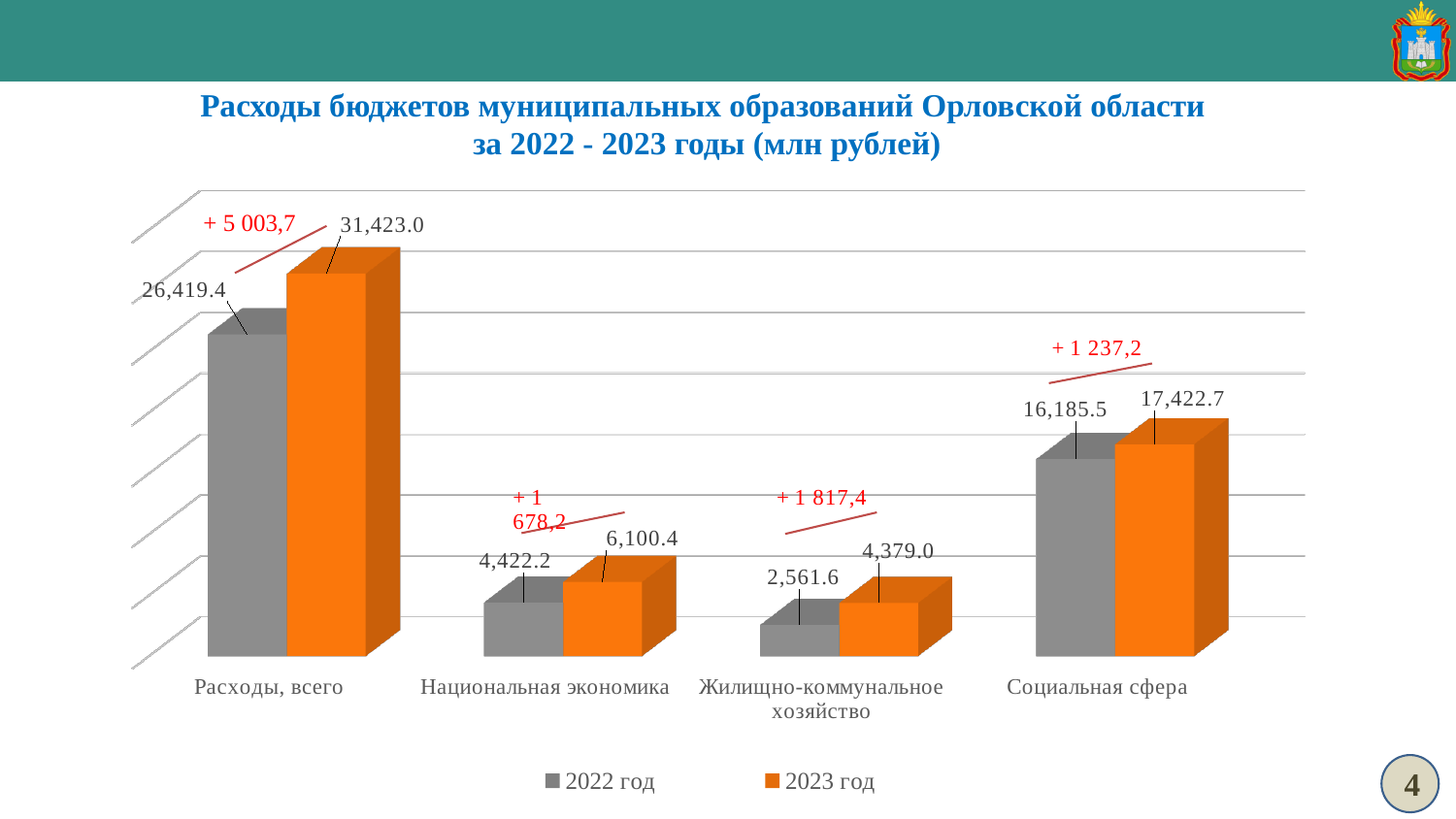
How many series does the legend list? 2 What is the value for Расходы, всего in the 2023 год series? 31,423.0 What kind of chart is shown on the slide? Bar chart Which category has the highest value in the 2023 год series? Расходы, всего What is the value for Национальная экономика in the 2023 год series? 6,100.4 What is the value for Социальная сфера in the 2022 год series? 16,185.5 What is the difference between the 2023 год and 2022 год values for Жилищно-коммунальное хозяйство? 1,817.4 What is the difference between the 2023 год and 2022 год values for Национальная экономика? 1,678.2 Which category has the lowest value in the 2022 год series? Жилищно-коммунальное хозяйство How many categories are shown on the x axis? 4 What is the value for Жилищно-коммунальное хозяйство in the 2022 год series? 2,561.6 Which is larger for Социальная сфера: the 2022 год value or the 2023 год value? 2023 год